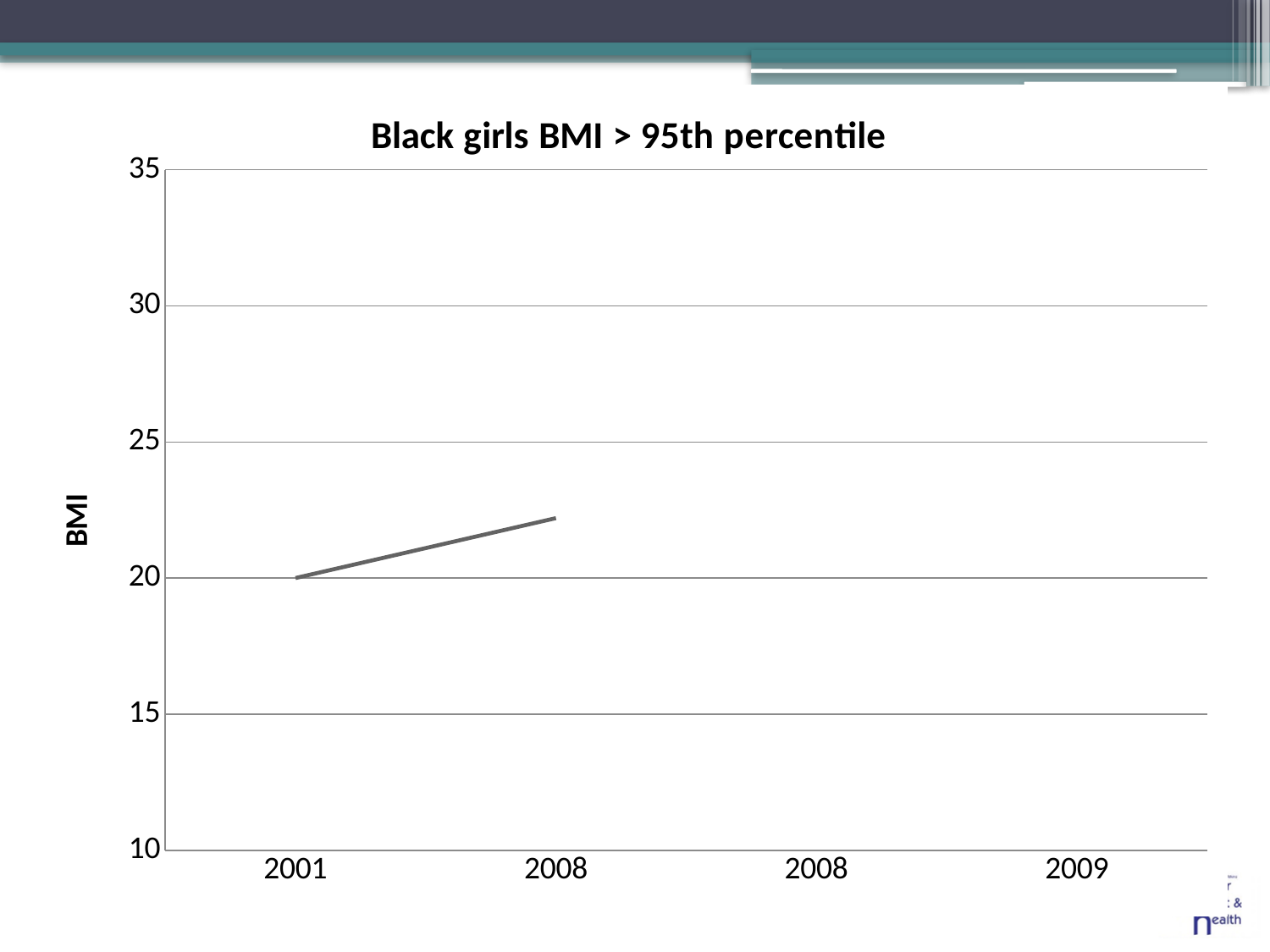
Is the BMI value for the first 2008 point greater or less than 20? greater Which plotted point has the lowest BMI value? 2001 Which has the higher plotted BMI value, 2001 or the first 2008 point? 2008 Does the plotted line rise or fall from 2001 to 2008? rise What is the label on the vertical axis of the chart? BMI Is the BMI value for the first 2008 point greater or less than 25? less What is the BMI value plotted for 2001? 20 How many category labels are shown along the x axis? 4 What is the title of the chart? Black girls BMI > 95th percentile What is the highest value shown on the vertical axis? 35 What kind of chart is shown on the slide? line chart